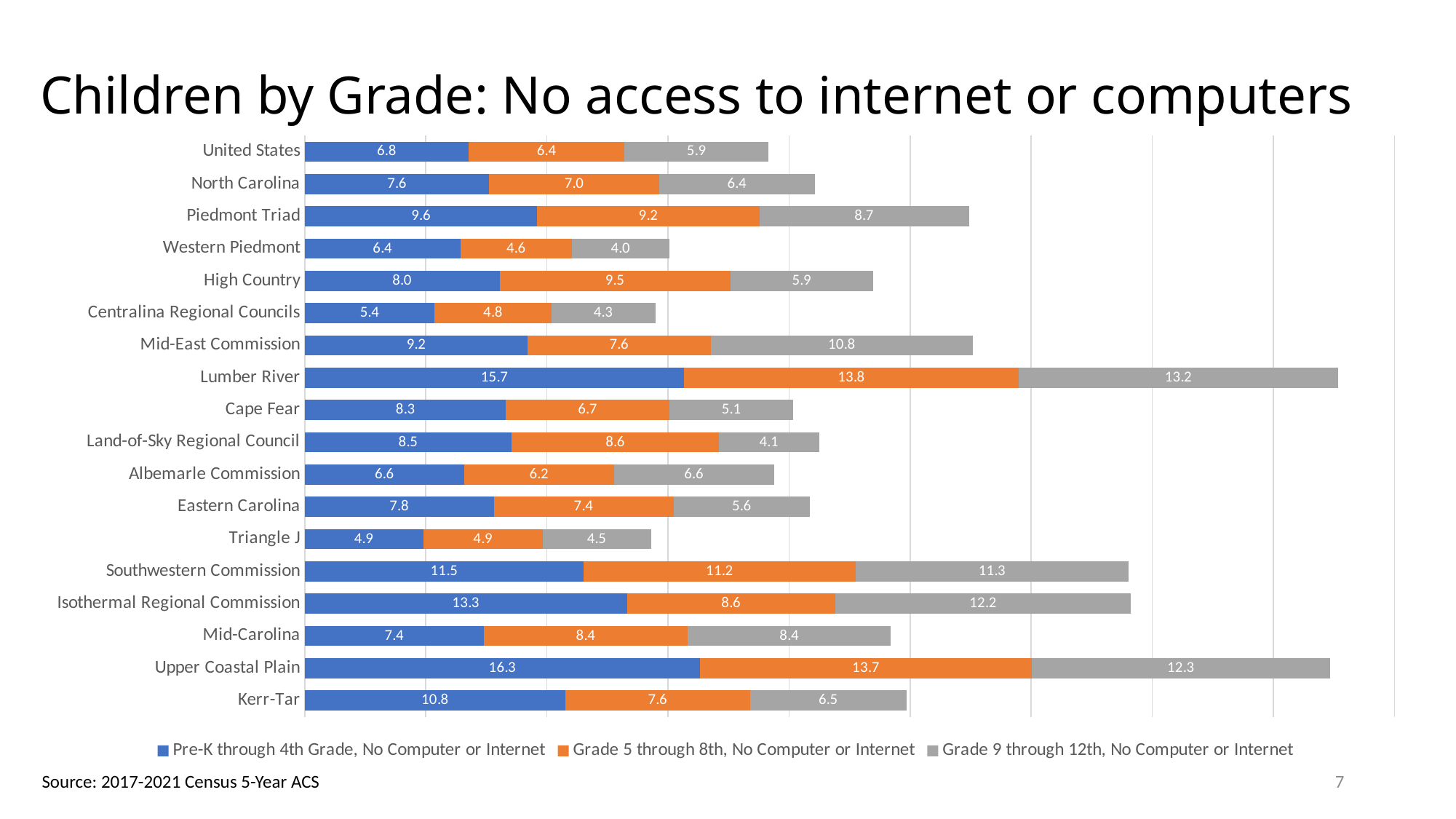
How many series does the legend list? 3 What is the difference between the Pre-K through 4th Grade values for North Carolina and the United States? 0.8 What is the value for Grade 9 through 12th, No Computer or Internet for Mid-East Commission? 10.8 What kind of chart is shown on the slide? Stacked bar chart How many regions or areas are shown on the chart? 18 What is the value for Grade 5 through 8th, No Computer or Internet for Lumber River? 13.8 Which region has the highest value for Pre-K through 4th Grade, No Computer or Internet? Upper Coastal Plain What is the value for Pre-K through 4th Grade, No Computer or Internet for North Carolina? 7.6 What is the total of the stacked bar for Triangle J? 14.3 What is the title of the chart? Children by Grade: No access to internet or computers Which has a larger Pre-K through 4th Grade value: Piedmont Triad or High Country? Piedmont Triad Which region has the lowest value for Grade 9 through 12th, No Computer or Internet? Western Piedmont